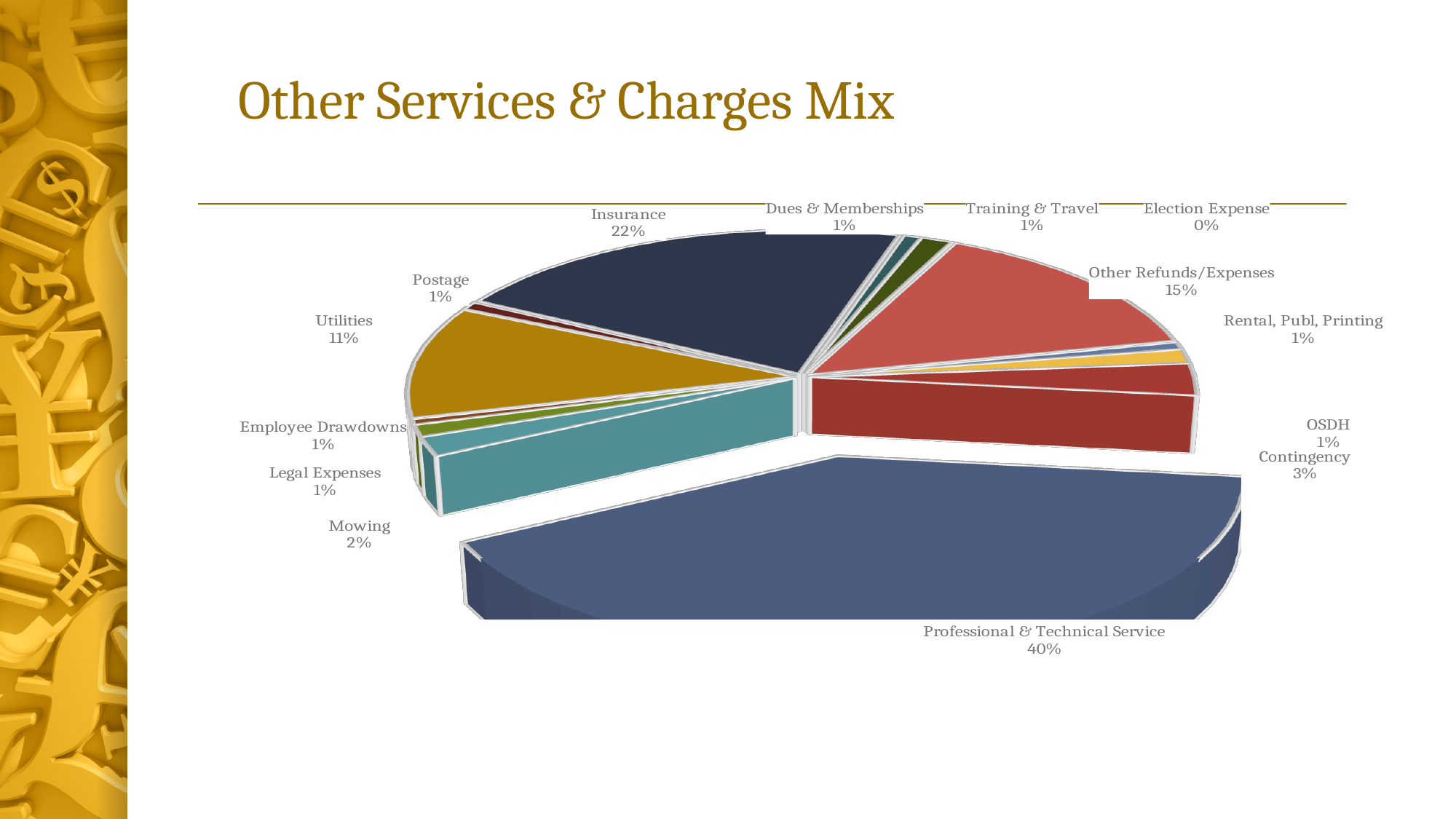
What is the value shown for Contingency? 3% Which is larger, Utilities or Other Refunds/Expenses? Other Refunds/Expenses What share of the pie does Professional & Technical Service represent? 40% What is the difference in percentage points between Professional & Technical Service and Insurance? 18 What is the value shown for Other Refunds/Expenses? 15% Which category has the smallest share of the pie? Election Expense What is the title of the chart on the slide? Other Services & Charges Mix What is the value shown for Utilities? 11% How many categories are labelled on the pie chart? 14 What kind of chart is shown on the slide? Pie chart Which category has the largest share of the pie? Professional & Technical Service What share of the pie does Insurance represent? 22%